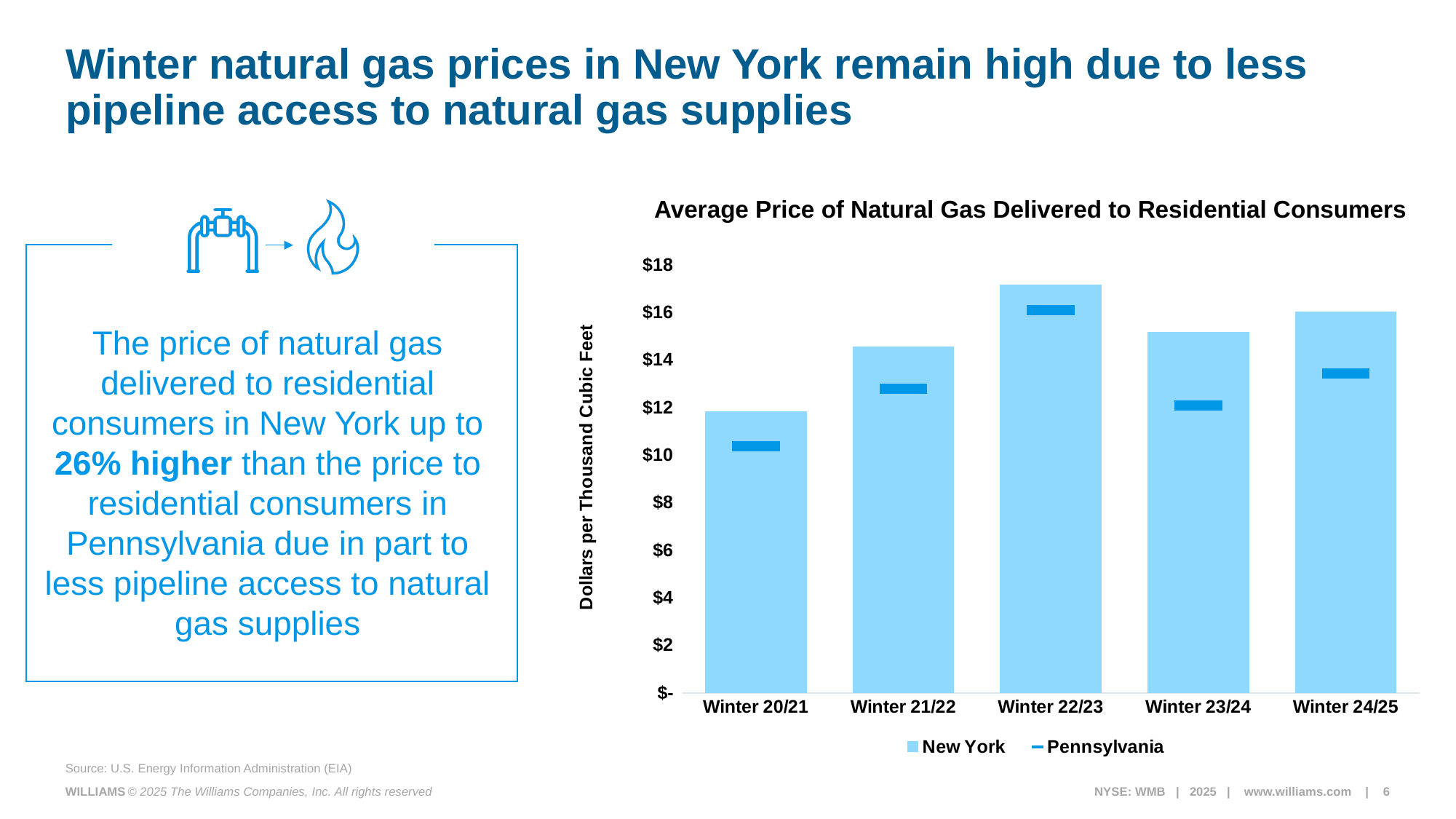
Is the New York value for Winter 22/23 greater or less than $16? greater Does the New York price rise or fall from Winter 20/21 to Winter 22/23? rise What is the title of the chart? Average Price of Natural Gas Delivered to Residential Consumers Is the New York value for Winter 21/22 greater or less than $14? greater Which winter has the highest New York price in the chart? Winter 22/23 Is the Pennsylvania value for Winter 24/25 greater or less than $14? less How many series does the chart legend list? 2 What kind of chart is shown on the slide? bar chart Which winter has the highest Pennsylvania price in the chart? Winter 22/23 Which winter has the lowest New York price in the chart? Winter 20/21 How many winter periods are shown on the x axis of the chart? 5 In Winter 23/24, which is higher, the New York price or the Pennsylvania price? New York